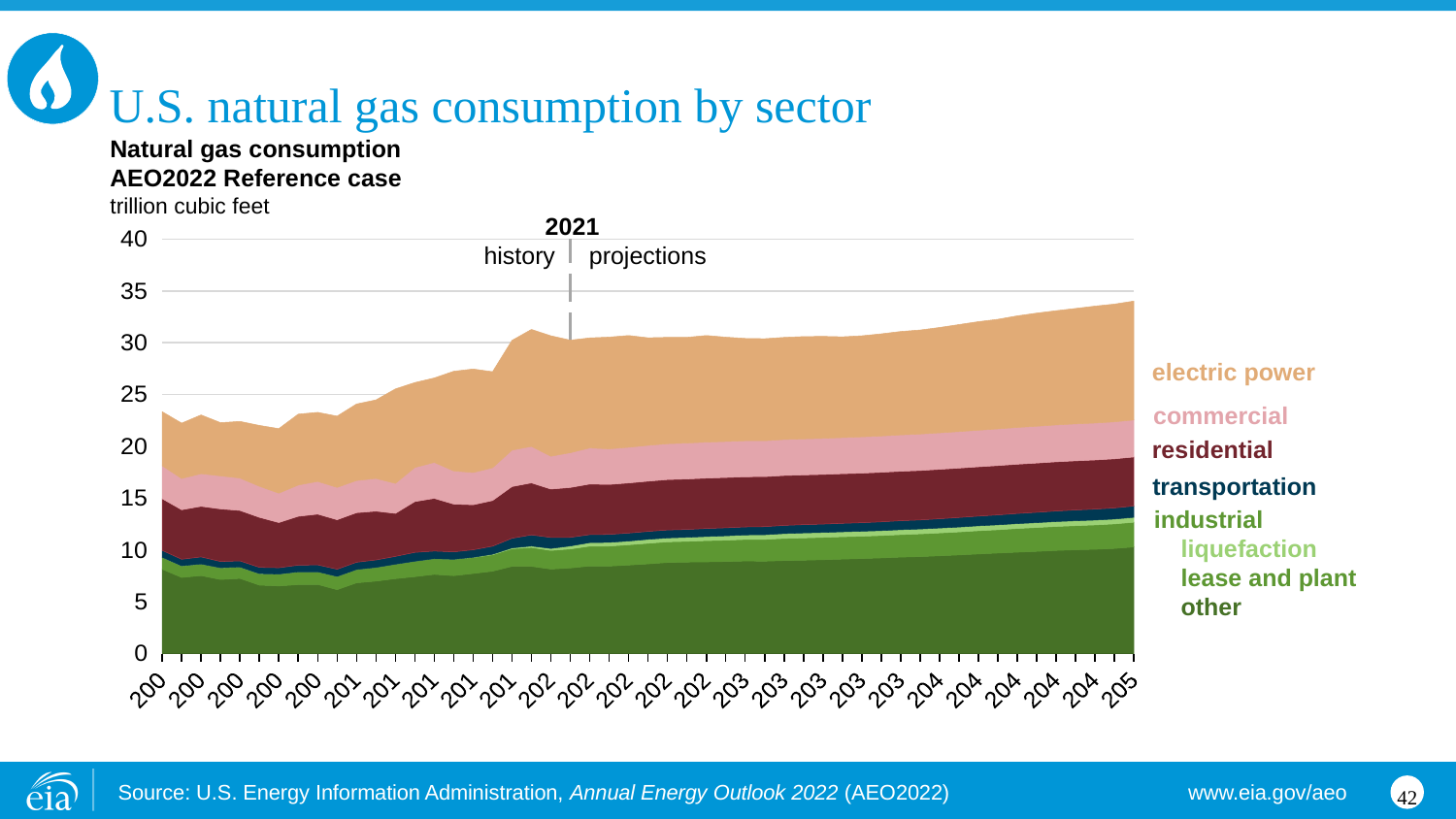
Does total natural gas consumption rise or fall over the projection period after 2021? rise Is the total natural gas consumption at the end of the projection period (2050) greater or less than 30 trillion cubic feet? greater Is the total natural gas consumption at the end of the projection period greater or less than 35 trillion cubic feet? less Which sector accounts for the largest share of natural gas consumption at the end of the projection period? industrial What year separates history from projections in the chart? 2021 What unit is used on the y-axis of the chart? trillion cubic feet Which is larger at the end of the projection period: electric power consumption or commercial consumption? electric power What is the highest value shown on the y-axis? 40 Is the total natural gas consumption at the start of the chart (around 2000) greater or less than 25 trillion cubic feet? less What type of chart is shown on the slide? stacked area chart